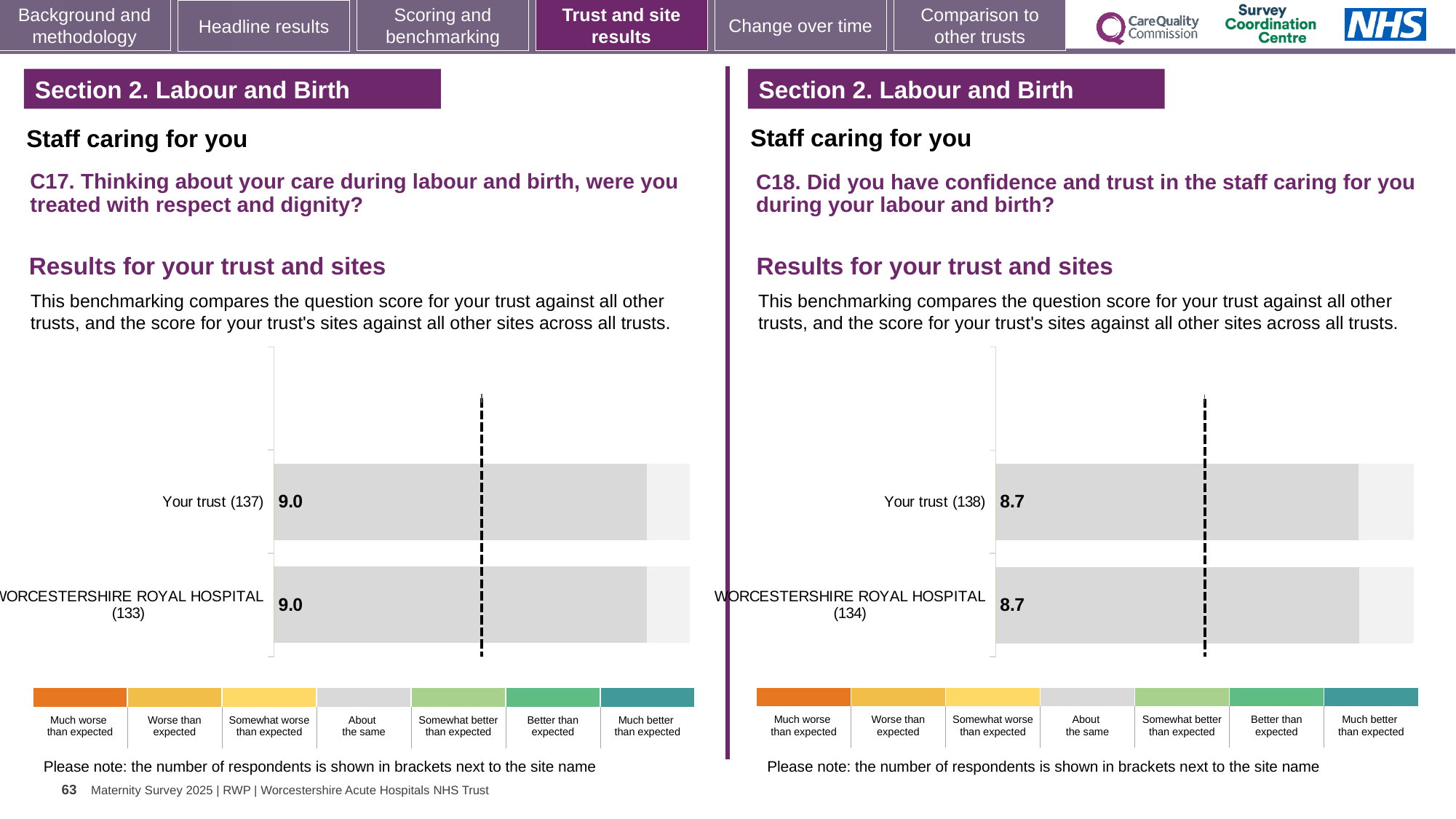
On the left chart (C17), what is the score for Your trust (137)? 9.0 What kind of chart is used on the left (C17) to show the results for your trust and sites? Bar chart On the left chart (C17), what is the difference between the score for Your trust and the score for WORCESTERSHIRE ROYAL HOSPITAL? 0.0 On the left chart (C17), how many respondents are shown in brackets for WORCESTERSHIRE ROYAL HOSPITAL? 133 On the right chart (C18), how many respondents are shown in brackets for Your trust? 138 On the right chart (C18), what is the score for WORCESTERSHIRE ROYAL HOSPITAL (134)? 8.7 In the colour key below the right chart (C18), what colour represents 'Much worse than expected'? Orange On the left chart (C17), how many bars are plotted? 2 On the left chart (C17), what is the score for WORCESTERSHIRE ROYAL HOSPITAL (133)? 9.0 On the right chart (C18), how many bars are plotted? 2 On the right chart (C18), what is the score for Your trust (138)? 8.7 How many categories does the colour key below the left chart (C17) list, from 'Much worse than expected' to 'Much better than expected'? 7